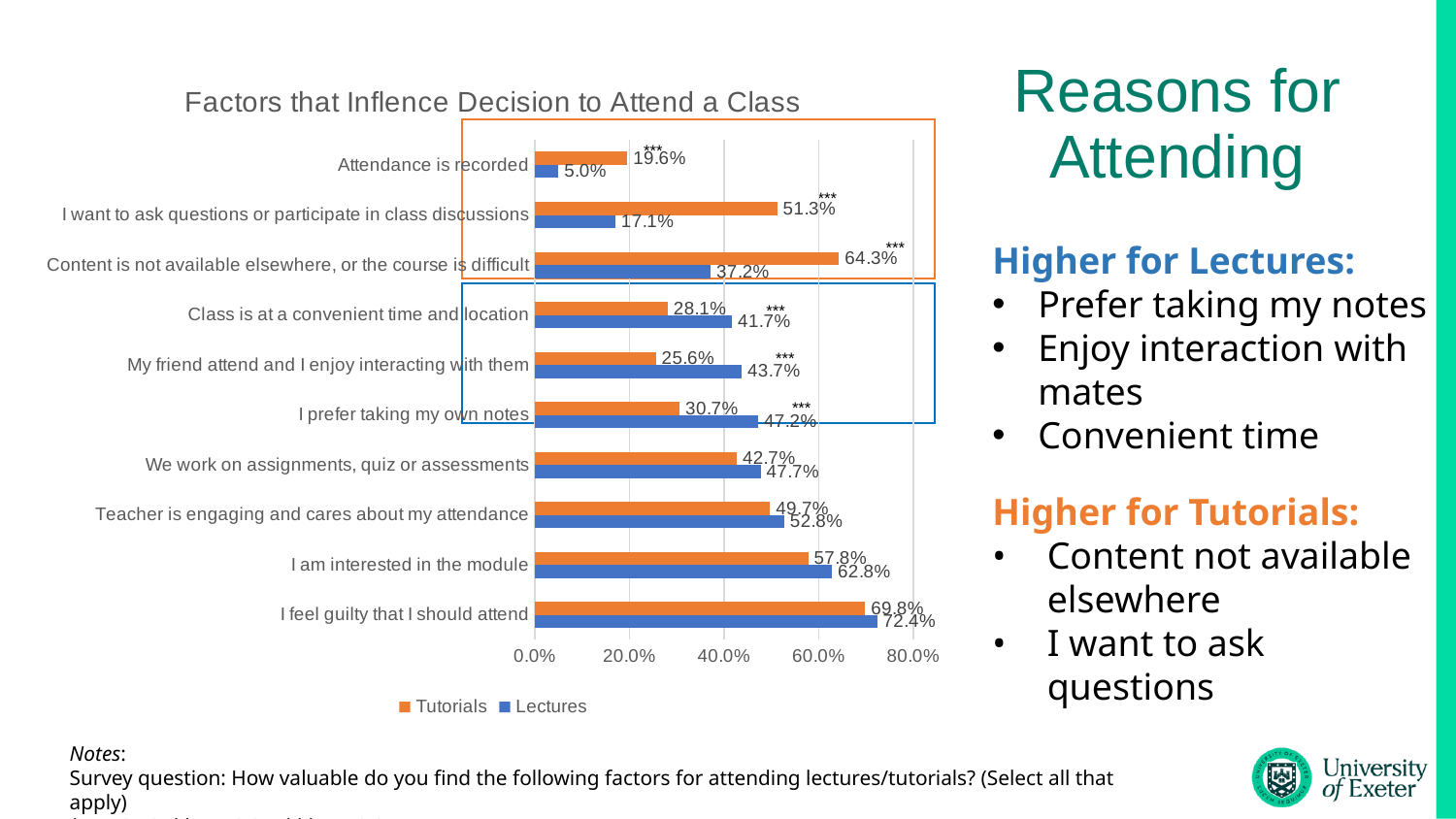
How many series does the legend list? 2 What is the Lectures value for 'Attendance is recorded'? 5.0% How many factors (categories) are plotted in the chart? 10 What is the Tutorials value for 'Content is not available elsewhere, or the course is difficult'? 64.3% What is the difference between the Tutorials and Lectures values for 'I want to ask questions or participate in class discussions'? 34.2% Is the Tutorials value for 'I feel guilty that I should attend' greater or less than 60.0%? greater For 'My friend attend and I enjoy interacting with them', which series has the larger value, Tutorials or Lectures? Lectures Which colour represents the Tutorials series in the chart? Orange Which factor has the lowest Tutorials value? Attendance is recorded What kind of chart is shown on the slide? Bar chart Which factor has the highest Lectures value? I feel guilty that I should attend What is the Lectures value for 'I prefer taking my own notes'? 47.2%